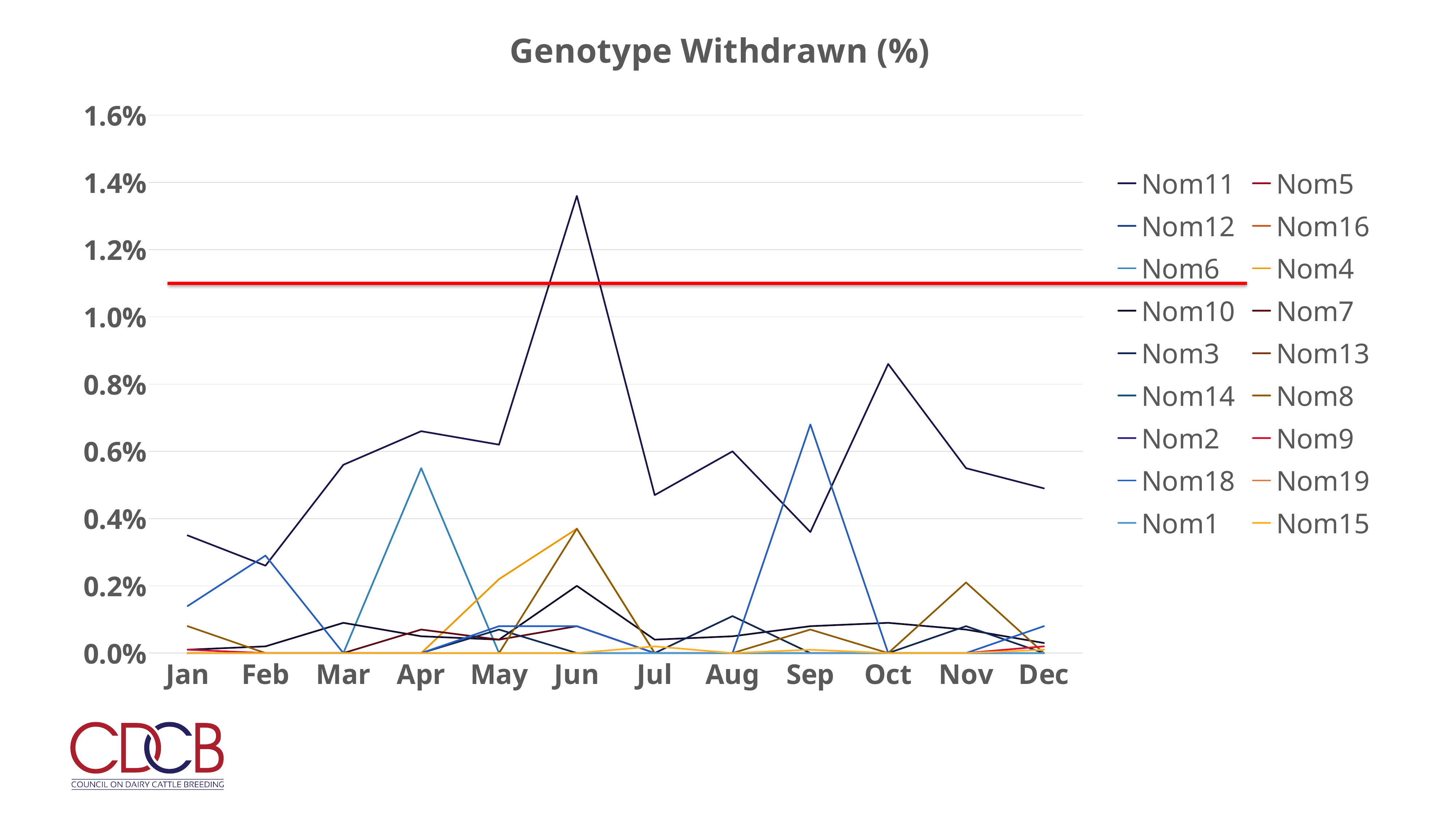
Is the highest value plotted in Jul greater or less than 0.6%? less Is the highest value plotted in Jan greater or less than 0.4%? less What kind of chart is shown on the slide? line chart Is the highest value plotted in Oct greater or less than 0.8%? greater Does the highest plotted value rise or fall from Jun to Jul? fall How many months are shown along the x axis of the chart? 12 What is the highest tick value shown on the y axis? 1.6% Which is larger: the highest value plotted in Jun or the highest value plotted in Oct? Jun In which month does the highest value on the chart occur? Jun How many series does the chart's legend list? 18 What is the title of the chart? Genotype Withdrawn (%)